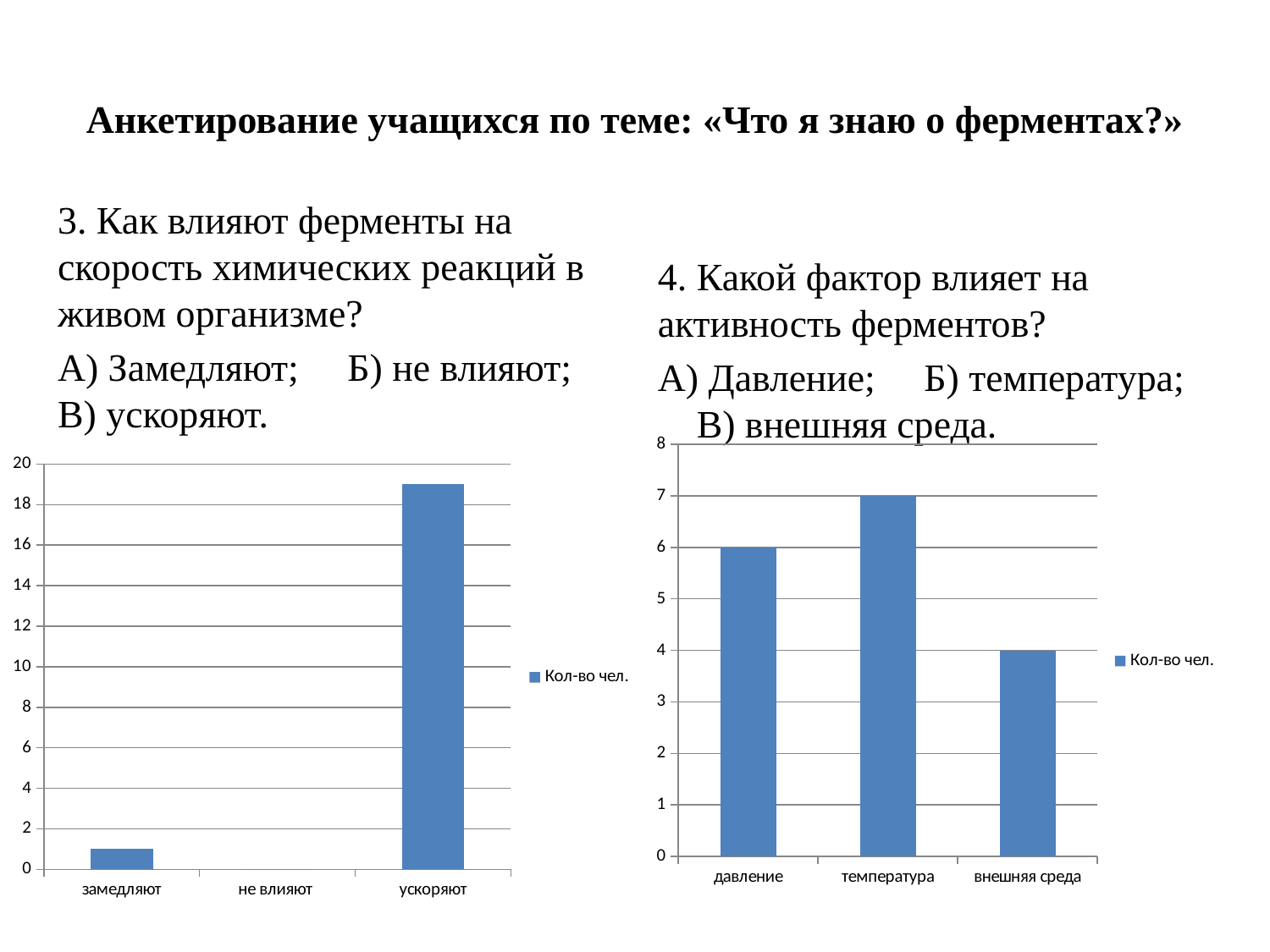
In the left chart (question 3), is the value for замедляют greater or less than 2? less In the left chart (question 3), is the value for ускоряют greater or less than 18? greater In the right chart (question 4), which category has the lowest value? внешняя среда In the left chart (question 3), which is larger, the value for замедляют or the value for ускоряют? ускоряют In the left chart (question 3), which category has the highest value? ускоряют What kind of chart is the left chart (question 3)? bar chart In the right chart (question 4), how many categories are shown on the x axis? 3 In the right chart (question 4), what is the value for внешняя среда? 4 In the right chart (question 4), what is the value for давление? 6 In the right chart (question 4), which category has the highest value? температура In the right chart (question 4), what is the value for температура? 7 In the right chart (question 4), what is the difference between the values for температура and внешняя среда? 3